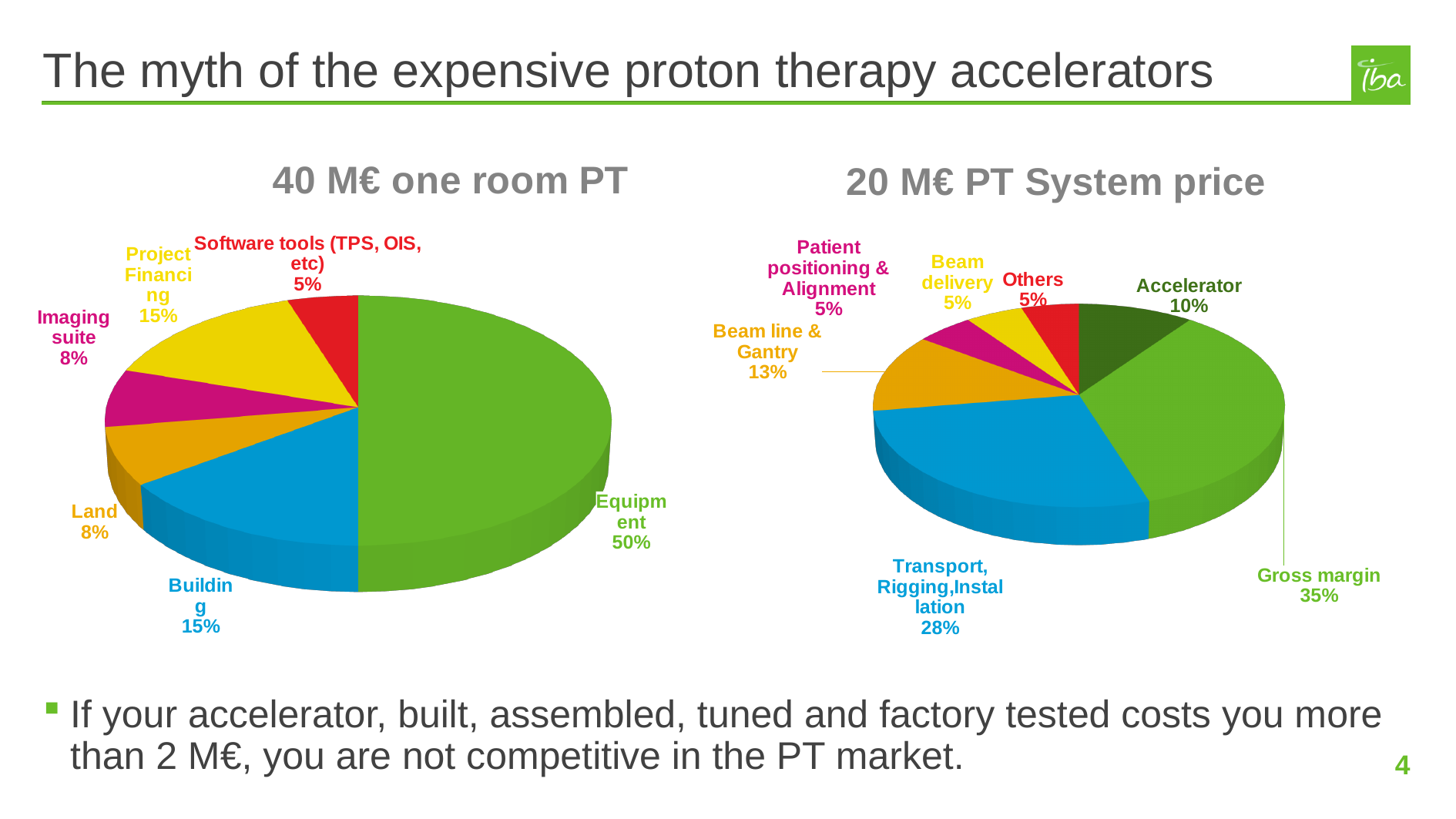
In the '40 M€ one room PT' chart, what is the value for Land? 8% In the '40 M€ one room PT' chart, what is the difference between the Equipment share and the Building share? 35% In the '20 M€ PT System price' chart, what is the value for Transport, Rigging, Installation? 28% How many categories are shown in the '40 M€ one room PT' chart? 6 In the '20 M€ PT System price' chart, which category has the largest share? Gross margin In the '40 M€ one room PT' chart, what share does Equipment account for? 50% What type of chart is used for the '20 M€ PT System price' data? Pie chart In the '40 M€ one room PT' chart, which category has the smallest share? Software tools (TPS, OIS, etc) In the '20 M€ PT System price' chart, what is the difference between Gross margin and Transport, Rigging, Installation? 7% In the '20 M€ PT System price' chart, what share does the Accelerator account for? 10% In the '20 M€ PT System price' chart, which is larger: Beam line & Gantry or Accelerator? Beam line & Gantry How many categories are shown in the '20 M€ PT System price' chart? 7